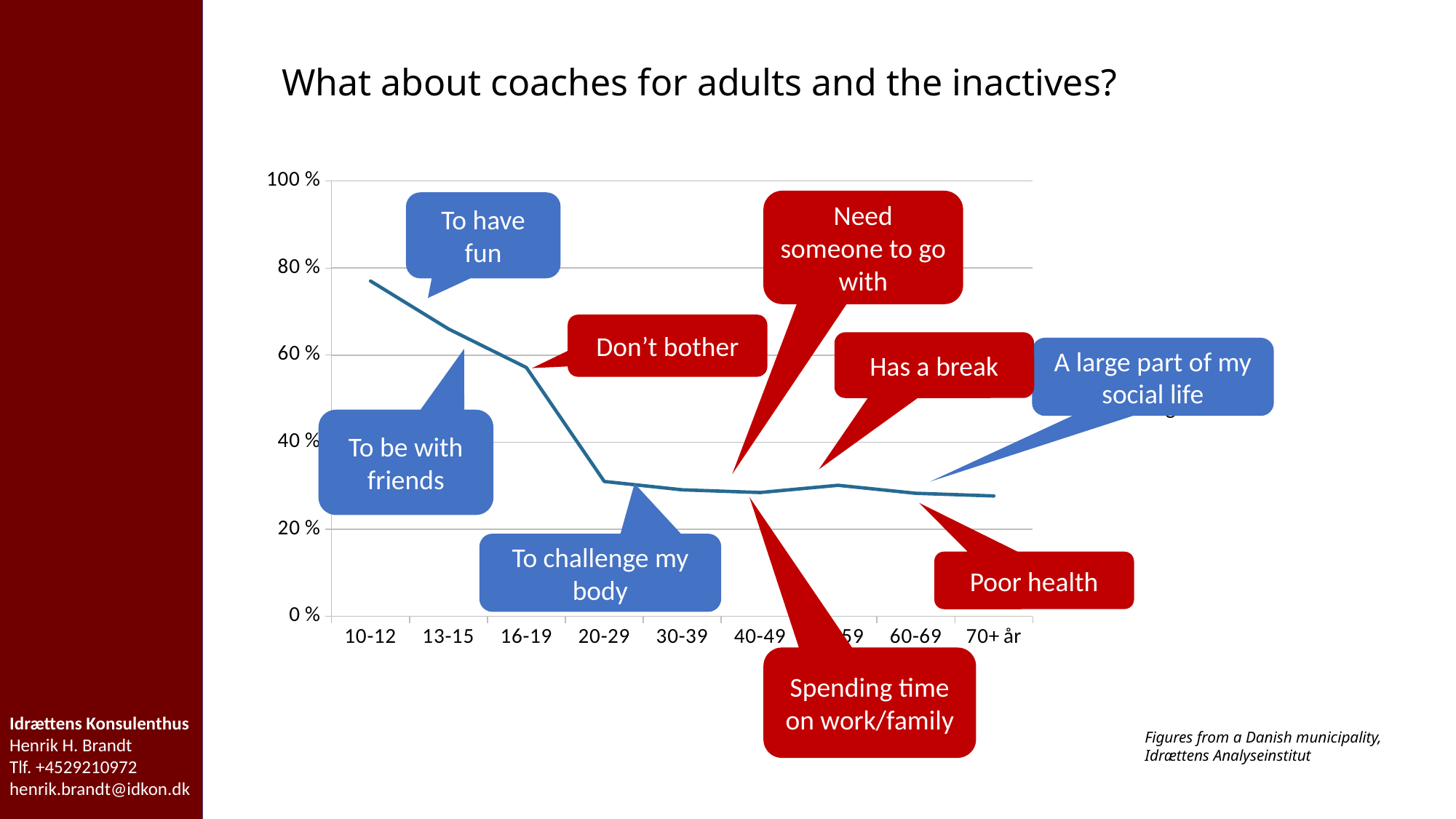
Do the values generally rise or fall as age increases along the x axis? fall How many age groups are shown along the x axis? 9 Is the value for the 13-15 age group greater or less than 60 %? greater Is the value for the 20-29 age group greater or less than 40 %? less What is the title of the slide? What about coaches for adults and the inactives? Is the value for the 10-12 age group greater or less than 60 %? greater Which has the larger value, the 10-12 age group or the 20-29 age group? 10-12 Which age group has the highest value? 10-12 Which has the larger value, the 13-15 age group or the 16-19 age group? 13-15 What kind of chart is shown on the slide? line chart